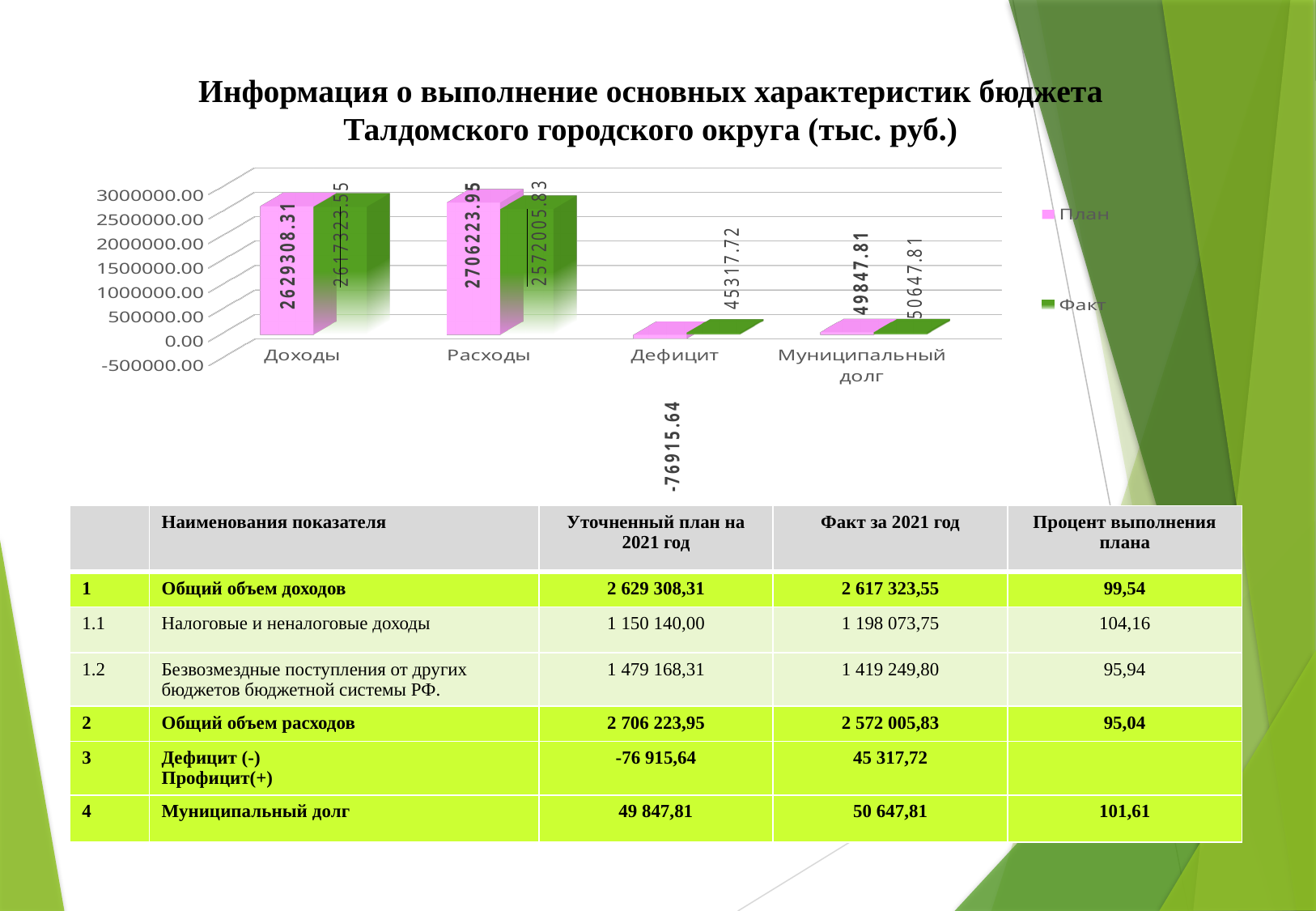
What type of chart is shown on the slide? Bar chart What is the difference between the Факт and План values for Муниципальный долг? 800.00 How many categories are shown on the x axis of the chart? 4 What is the Факт value for Расходы? 2572005.83 Which category has the highest План value? Расходы Which is larger for Доходы, the План value or the Факт value? План What is the План value for Дефицит? -76915.64 What is the План value for Доходы? 2629308.31 How many series does the chart legend list? 2 What is the difference between the План and Факт values for Расходы? 134218.12 Which category has the lowest Факт value? Дефицит What is the Факт value for Муниципальный долг? 50647.81